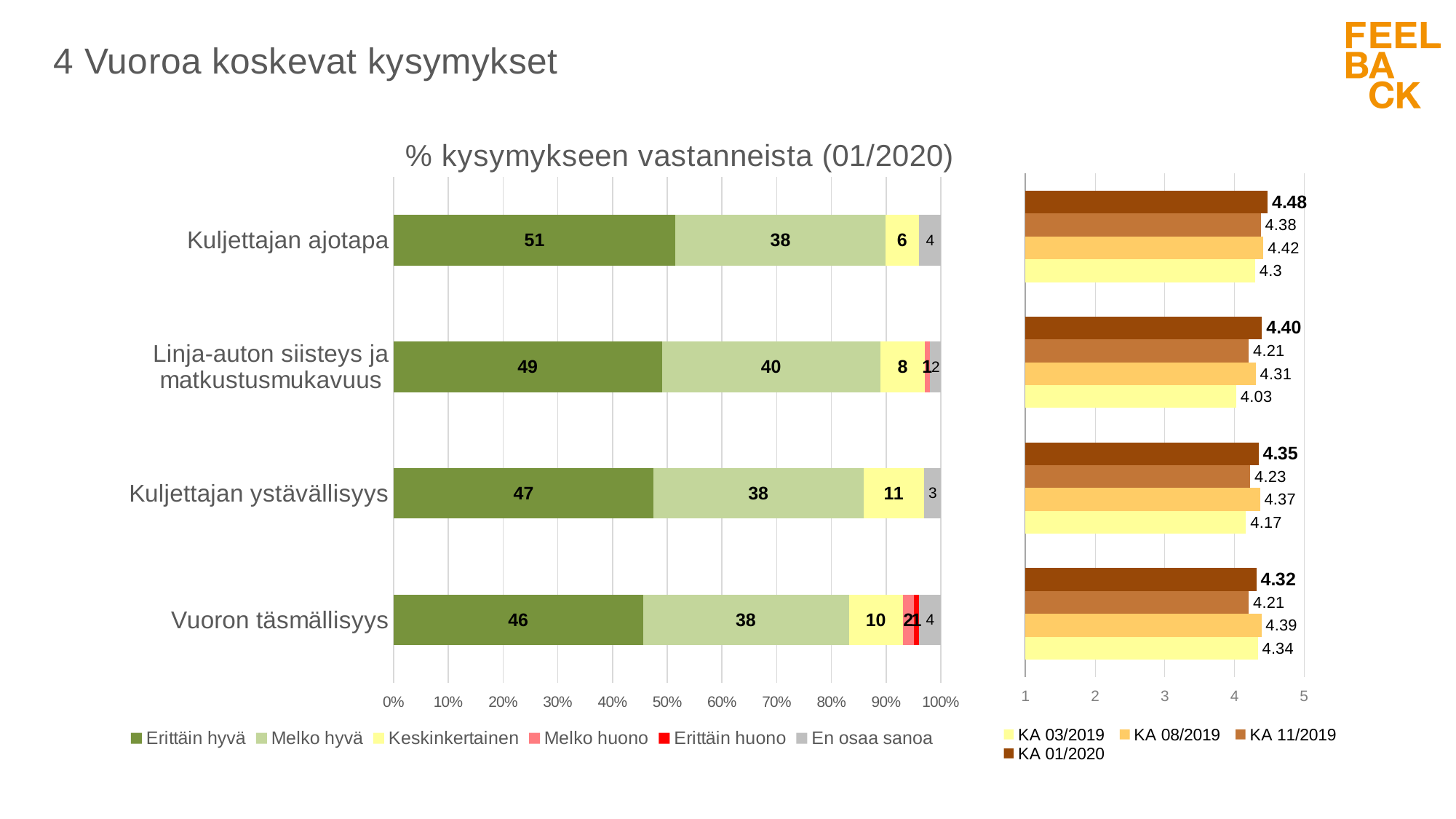
How many series does the legend of the right chart list? 4 In the right chart, what is the difference between the KA 01/2020 and KA 11/2019 values for Kuljettajan ajotapa? 0.10 In the right chart, what is the KA 03/2019 value for Linja-auton siisteys ja matkustusmukavuus? 4.03 How many series does the legend of the left chart '% kysymykseen vastanneista (01/2020)' list? 6 In the left chart '% kysymykseen vastanneista (01/2020)', what is the difference between the 'Keskinkertainen' values for Kuljettajan ystävällisyys and Kuljettajan ajotapa? 5 In the right chart, what is the KA 01/2020 value for Kuljettajan ajotapa? 4.48 What kind of chart is the left chart '% kysymykseen vastanneista (01/2020)'? Stacked bar chart In the right chart, which is larger for Vuoron täsmällisyys: KA 08/2019 or KA 11/2019? KA 08/2019 In the left chart '% kysymykseen vastanneista (01/2020)', what is the 'Erittäin hyvä' value for Kuljettajan ajotapa? 51 In the left chart '% kysymykseen vastanneista (01/2020)', which category has the lowest 'Erittäin hyvä' value? Vuoron täsmällisyys In the left chart '% kysymykseen vastanneista (01/2020)', what is the 'Melko hyvä' value for Linja-auton siisteys ja matkustusmukavuus? 40 In the left chart '% kysymykseen vastanneista (01/2020)', which category has the highest 'Erittäin hyvä' value? Kuljettajan ajotapa